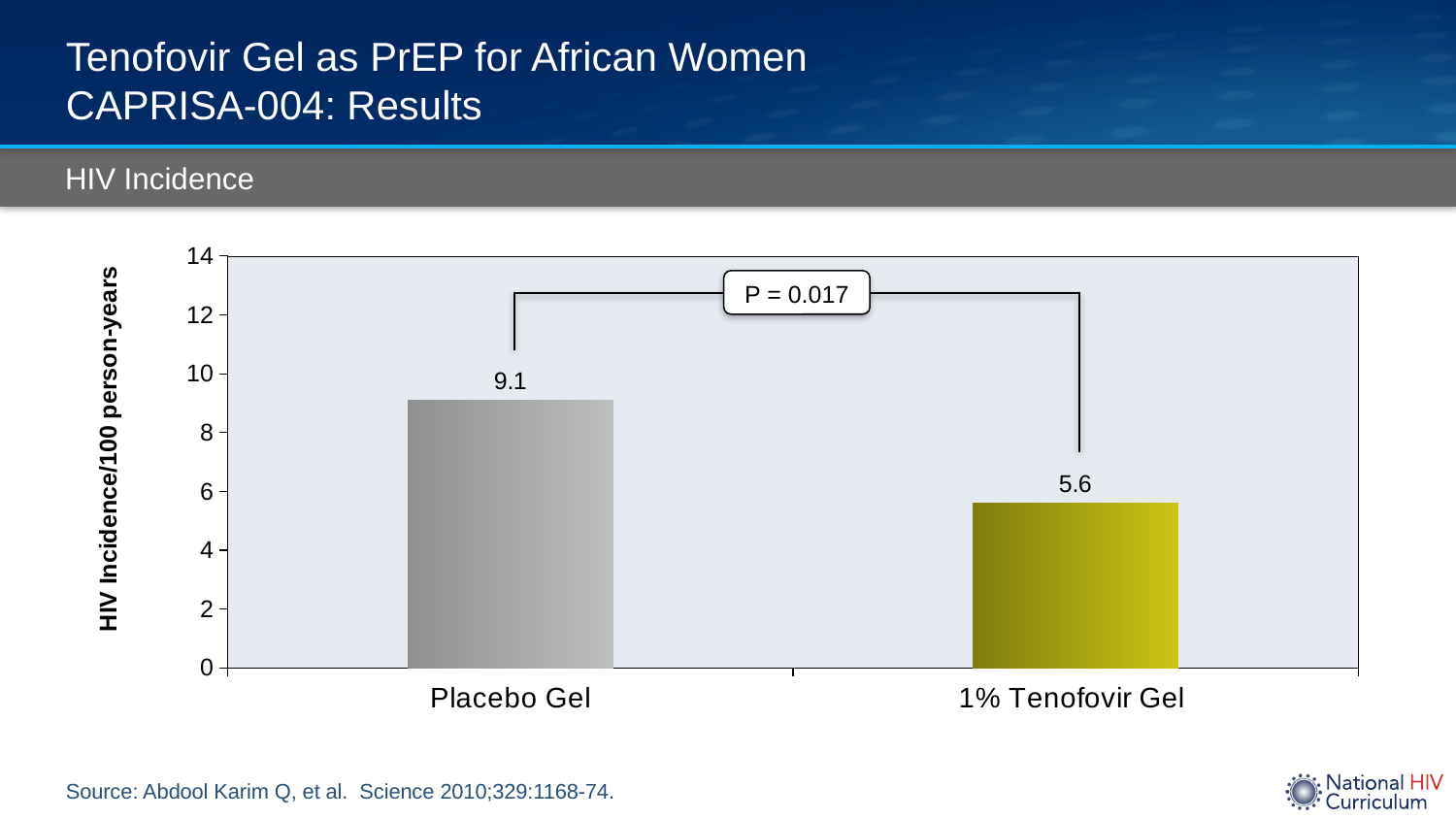
What is the P value shown on the chart? P = 0.017 Which group has the higher HIV incidence? Placebo Gel What kind of chart is shown on the slide? Bar chart Which group has the lower HIV incidence? 1% Tenofovir Gel What is the HIV incidence per 100 person-years for Placebo Gel? 9.1 Is the value for 1% Tenofovir Gel greater or less than 6? less What is the label of the y axis? HIV Incidence/100 person-years Is the value for Placebo Gel greater or less than 8? greater What is the difference in HIV incidence between Placebo Gel and 1% Tenofovir Gel? 3.5 What is the HIV incidence per 100 person-years for 1% Tenofovir Gel? 5.6 Is the HIV incidence higher for Placebo Gel or for 1% Tenofovir Gel? Placebo Gel How many categories are shown on the chart? 2